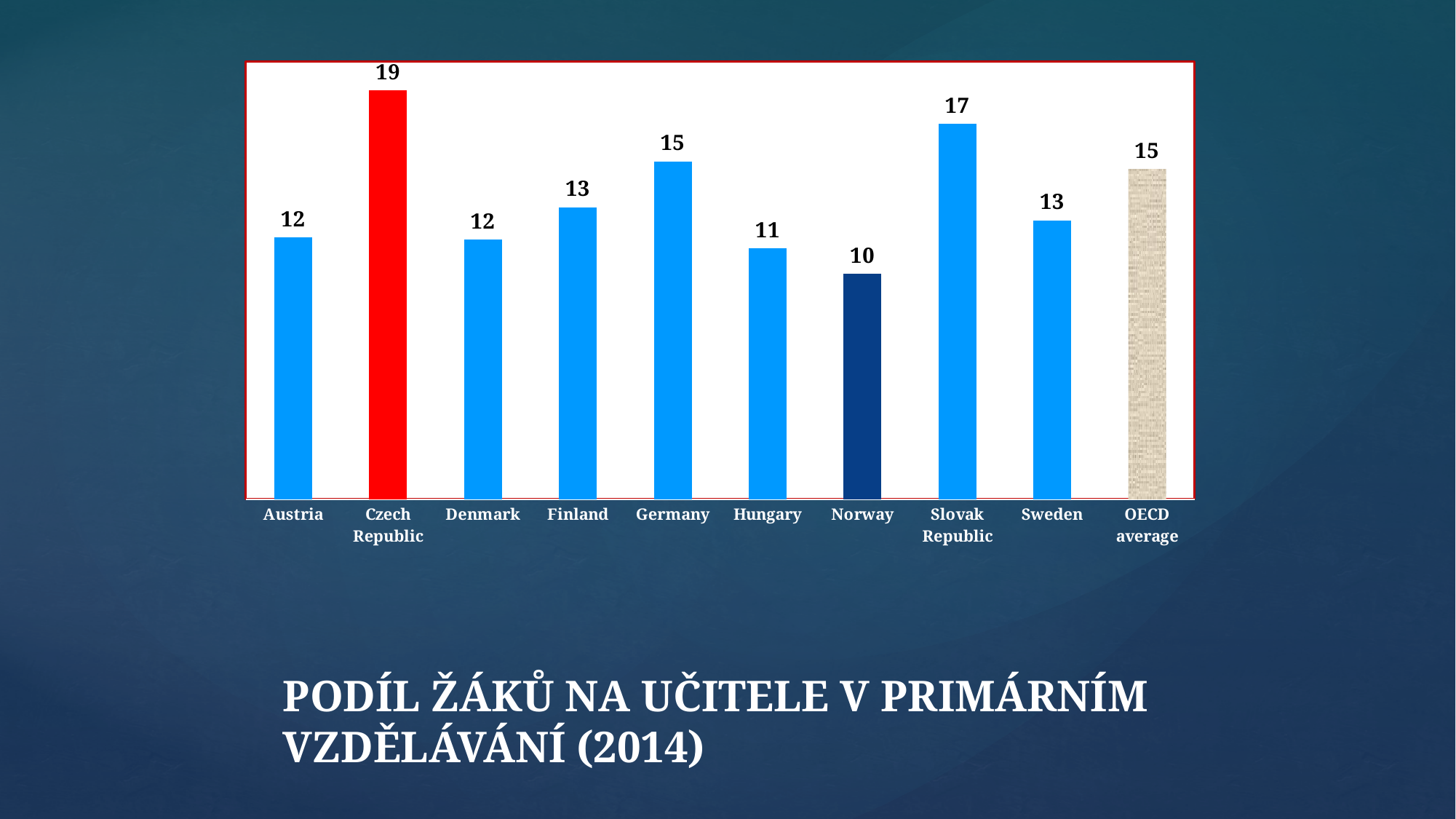
What is the value shown for the OECD average? 15 How many categories are shown on the x axis? 10 What kind of chart is shown on the slide? Bar chart Which category has the lowest value? Norway Which is larger, the value for Germany or the value for Finland? Germany What is the difference between the Slovak Republic and Hungary? 6 What is the value for Norway? 10 What is the difference between the Czech Republic and the OECD average? 4 Which is larger, the value for Austria or the value for Slovak Republic? Slovak Republic Which category has the highest value? Czech Republic What is the value for the Czech Republic? 19 Which bar is coloured red? Czech Republic